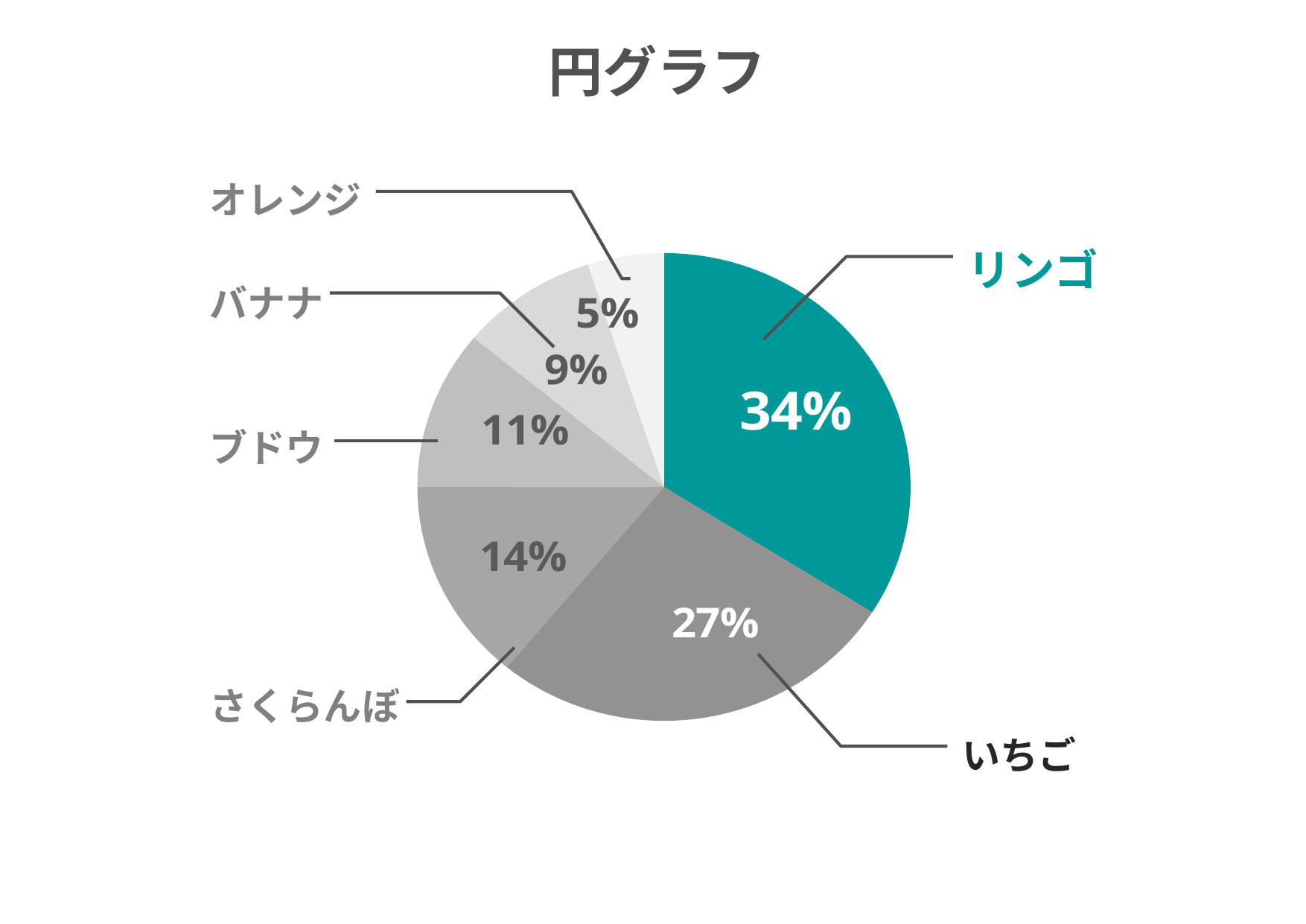
What percentage does the オレンジ slice represent? 5% What percentage does the リンゴ slice represent? 34% What percentage does the ブドウ slice represent? 11% What is the difference in percentage points between リンゴ and いちご? 7 What kind of chart is shown on the slide? pie chart How many slices does the pie chart have? 6 What percentage does the いちご slice represent? 27% Which category has the largest share of the pie? リンゴ Which category has the smallest share of the pie? オレンジ What percentage does the バナナ slice represent? 9% What percentage does the さくらんぼ slice represent? 14% What is the title of the chart? 円グラフ